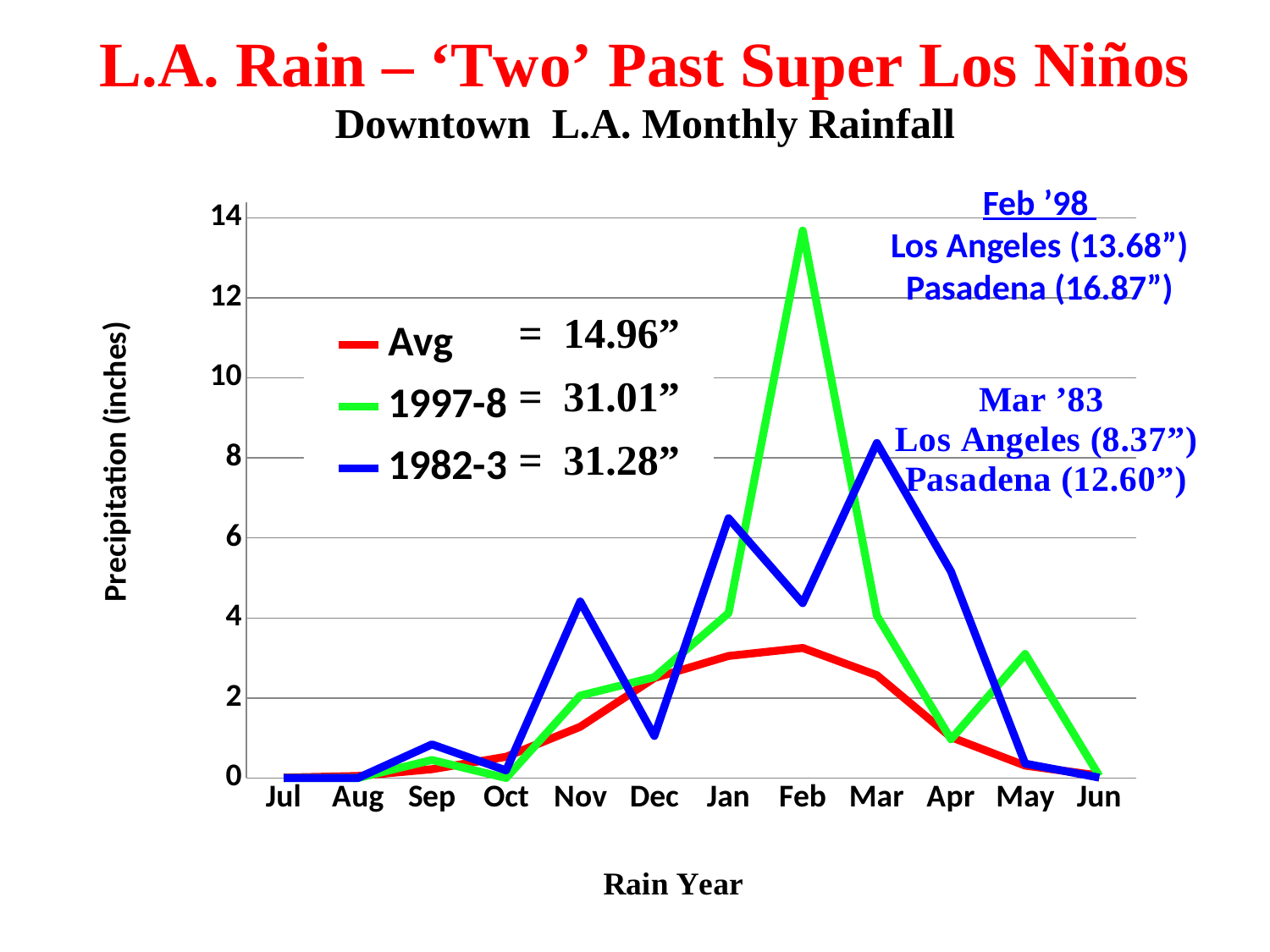
What season total is shown in the legend for 1982-3? 31.28" What is the Los Angeles rainfall value annotated for Mar '83? 8.37" In which month does the 1997-8 series reach its highest value? Feb In Nov, which series has the larger value, 1982-3 or 1997-8? 1982-3 Is the 1997-8 value for May greater or less than 2? greater What kind of chart is shown on the slide? line chart What is the Los Angeles rainfall value annotated for Feb '98? 13.68" What is the difference between the Los Angeles Feb '98 value and the Los Angeles Mar '83 value? 5.31" How many months are shown along the x axis? 12 Is the Avg value for Feb greater or less than 4? less How many series does the legend list? 3 In which month does the 1982-3 series reach its highest value? Mar